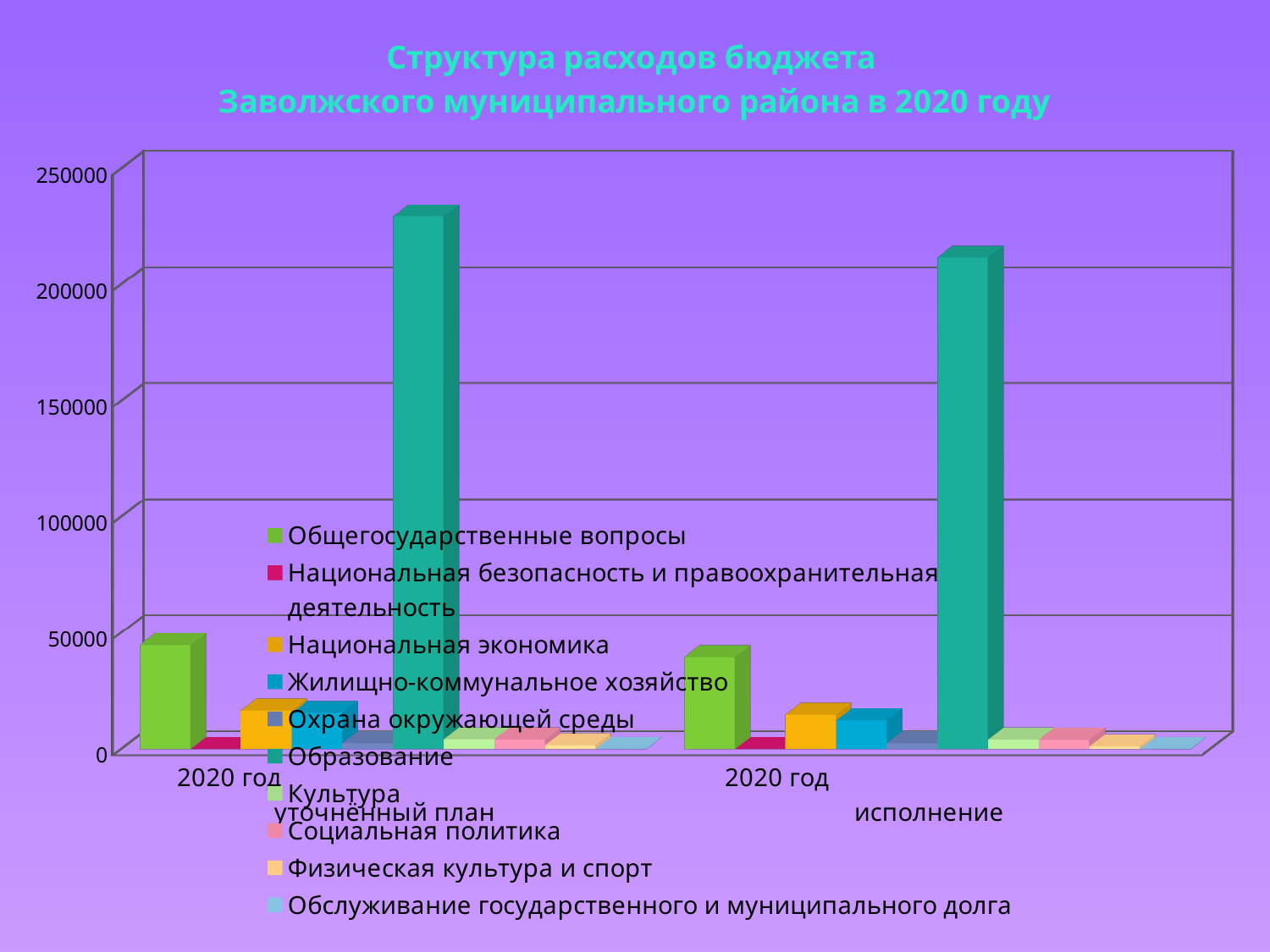
Does the value for Образование rise or fall from '2020 год уточнённый план' to '2020 год исполнение'? fall Is the value for Образование in '2020 год уточнённый план' greater or less than 200000? greater Which series has the highest value in the '2020 год уточнённый план' category? Образование Which is larger for Образование: the value in '2020 год уточнённый план' or in '2020 год исполнение'? 2020 год уточнённый план What kind of chart is shown on the slide? bar chart How many series does the legend list? 10 How many categories are shown on the x axis? 2 Is the value for Образование in '2020 год уточнённый план' greater or less than 250000? less Which series has the highest value in the '2020 год исполнение' category? Образование Is the value for Образование in '2020 год исполнение' greater or less than 200000? greater What is the title of the chart? Структура расходов бюджета Заволжского муниципального района в 2020 году